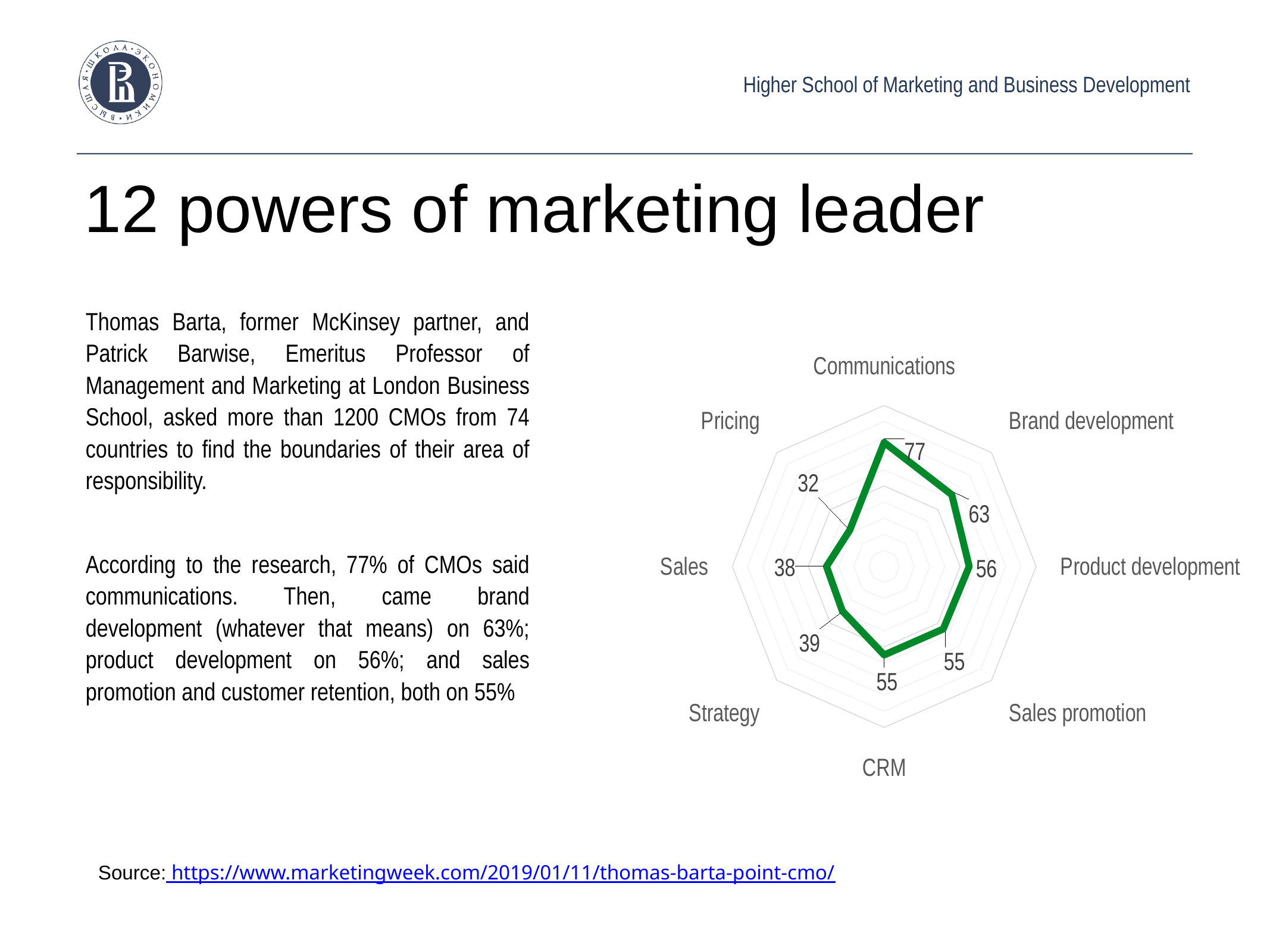
What is the difference between the values for Communications and Brand development? 14 What kind of chart is shown on the slide? radar chart Which category has the highest value? Communications What colour is the data line on the radar chart? green What is the value for Brand development? 63 What is the value for Pricing? 32 Which is larger, the value for Brand development or the value for Product development? Brand development How many categories does the radar chart have? 8 What is the difference between the values for Product development and Sales? 18 Which category has the lowest value? Pricing What is the value for Communications? 77 What is the value for Strategy? 39